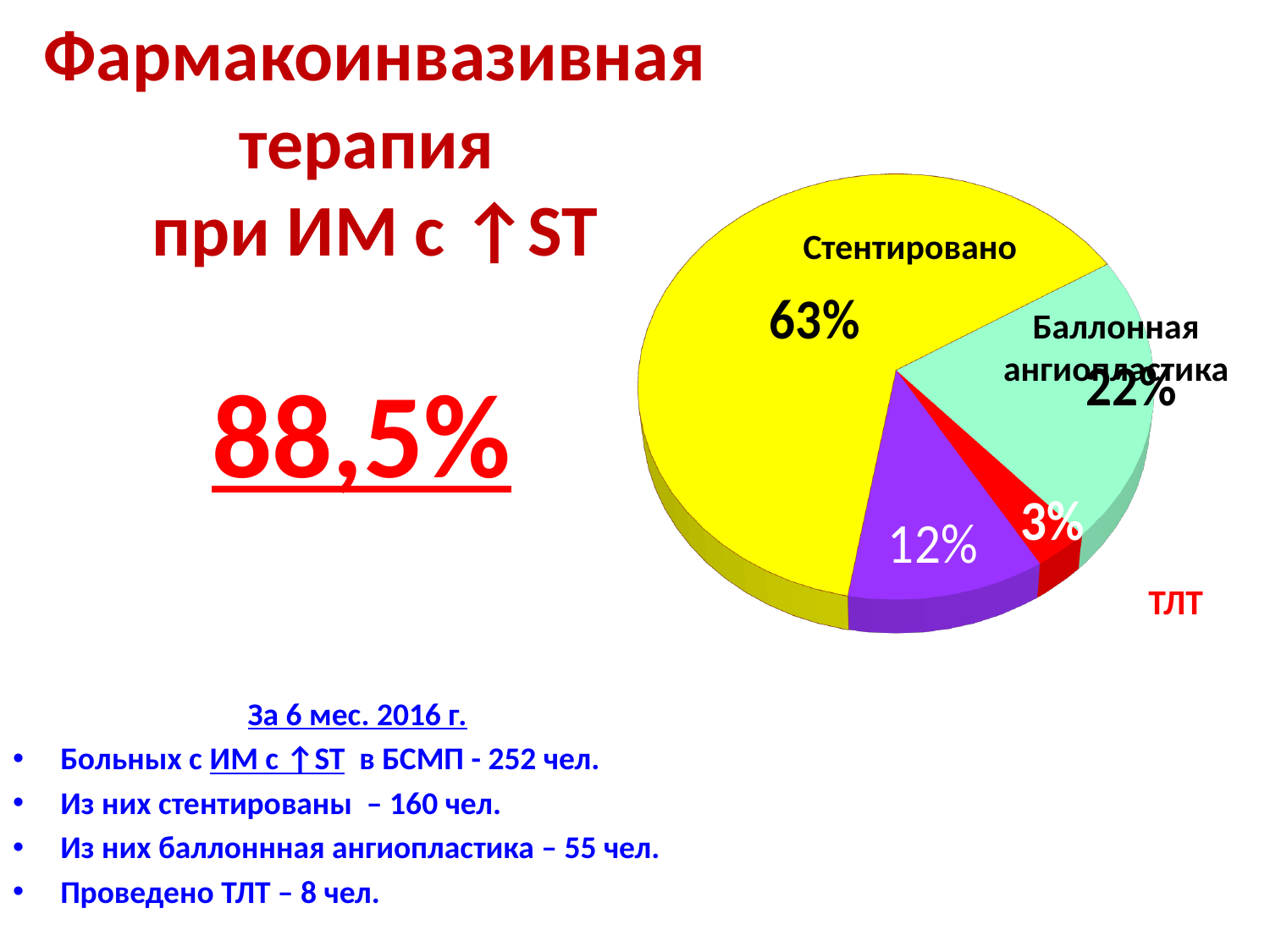
What share of the pie does the Стентировано slice take? 63% How many slices does the pie chart have? 4 What colour is the Стентировано slice? Yellow Which labelled slice of the pie chart is the smallest? ТЛТ What colour is the ТЛТ slice? Red What percentage of the pie chart is labelled Стентировано? 63% Which slice of the pie chart is the largest? Стентировано What percentage does the ТЛТ slice show? 3% What percentage does the Баллонная ангиопластика slice show? 22% Which is larger, the Баллонная ангиопластика slice or the ТЛТ slice? Баллонная ангиопластика By how many percentage points does Стентировано exceed Баллонная ангиопластика? 41 What kind of chart is shown on the slide? Pie chart